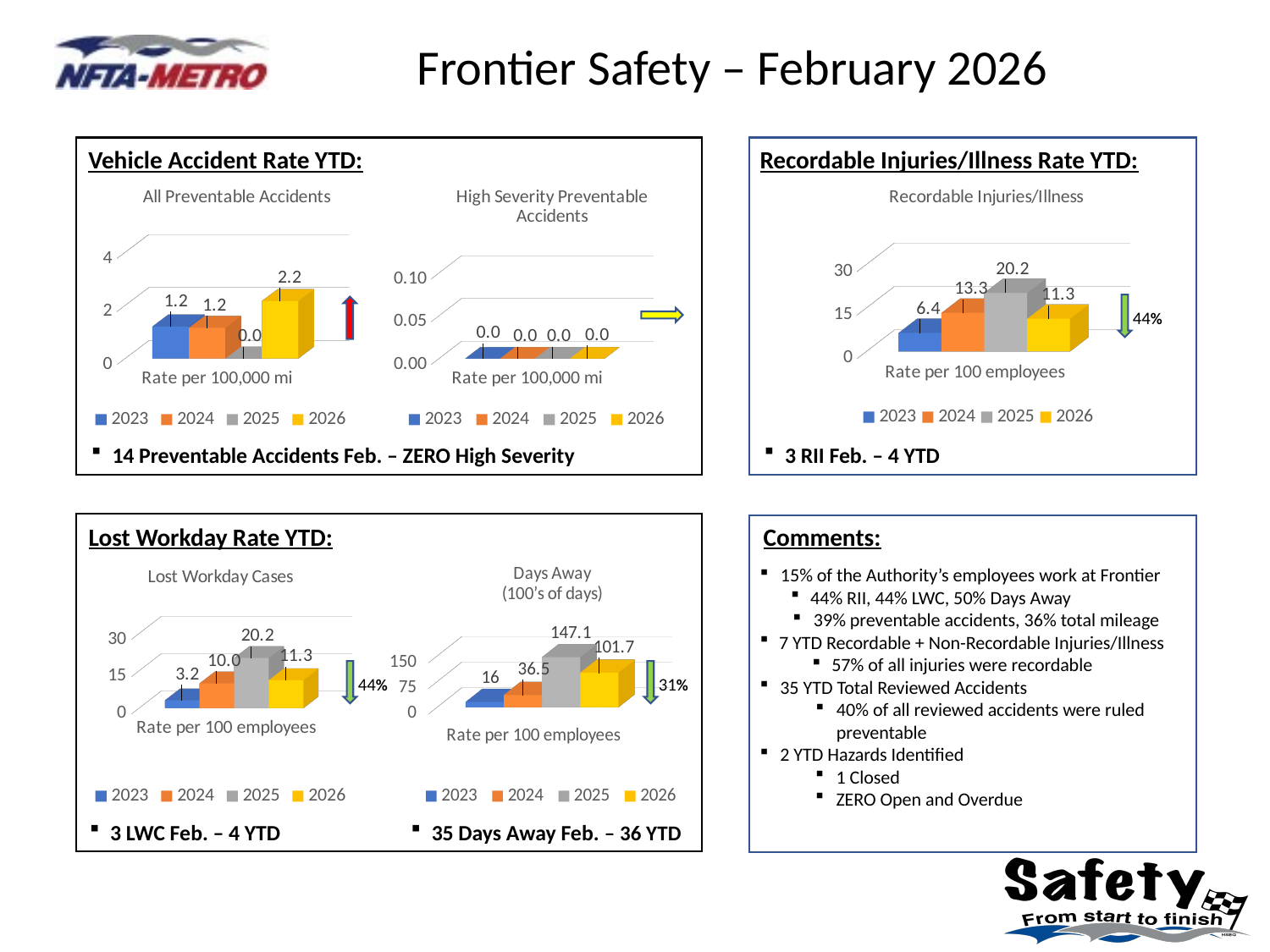
In the Days Away chart, what is the value for 2025? 147.1 What kind of chart is the Lost Workday Cases chart? Bar chart In the Days Away chart, which is larger, the value for 2024 or the value for 2026? 2026 How many series does the legend of the High Severity Preventable Accidents chart list? 4 In the All Preventable Accidents chart, what is the value for 2025? 0.0 In the Recordable Injuries/Illness chart, which year has the highest value? 2025 In the Recordable Injuries/Illness chart, what is the value for 2023? 6.4 In the Lost Workday Cases chart, what is the value for 2024? 10.0 In the Recordable Injuries/Illness chart, what is the difference between the 2025 and 2026 values? 8.9 In the Days Away chart, what is the difference between the 2025 and 2026 values? 45.4 In the All Preventable Accidents chart, what is the value for 2026? 2.2 In the Lost Workday Cases chart, which year has the lowest value? 2023